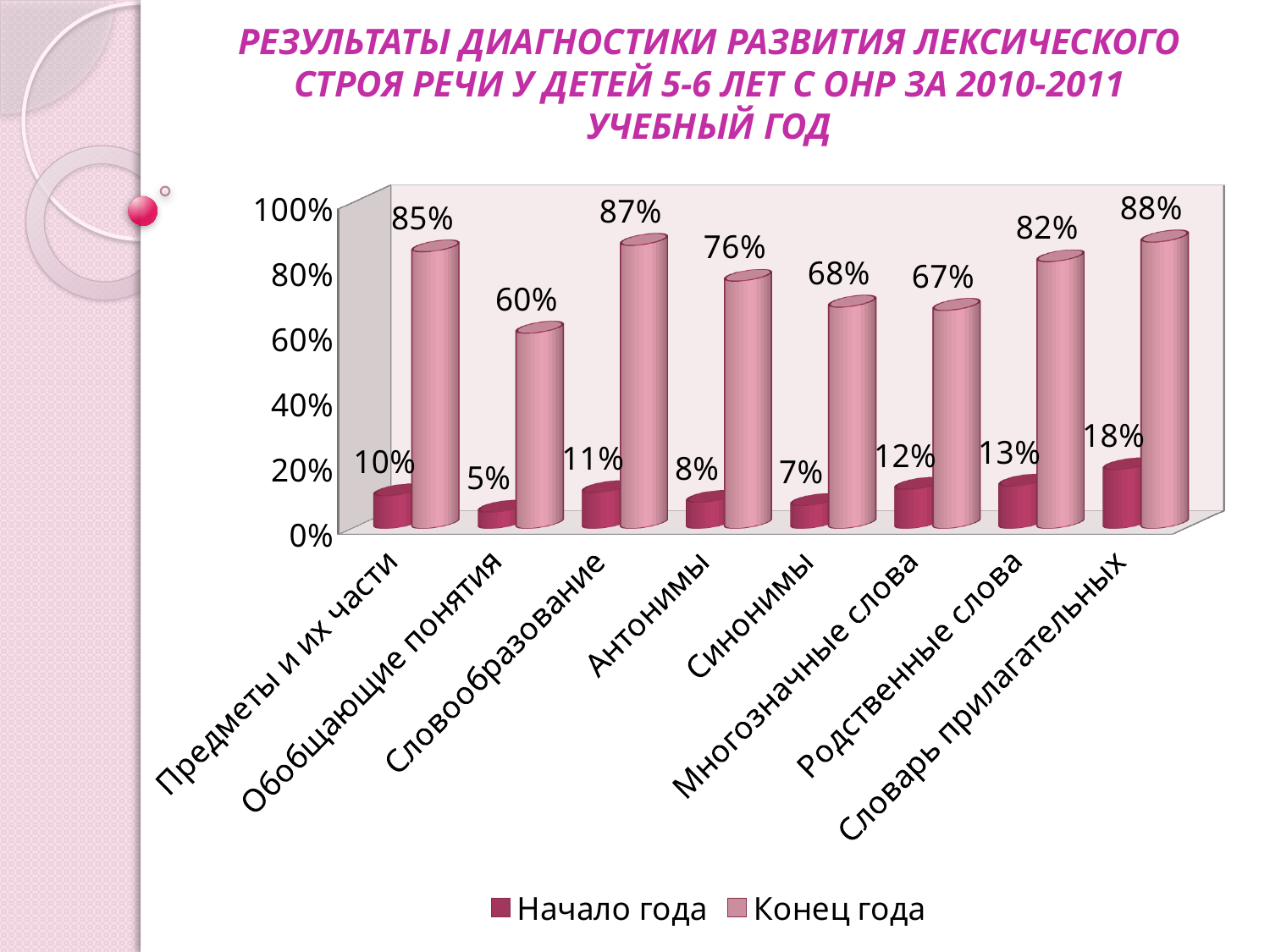
What is the value for Обобщающие понятия in the Начало года series? 5% How many categories are shown on the x axis? 8 Which category has the lowest value in the Начало года series? Обобщающие понятия What is the value for Синонимы in the Конец года series? 68% How many series does the legend list? 2 What is the difference between the Конец года and Начало года values for Антонимы? 68% Which is larger: the Конец года value for Родственные слова or for Многозначные слова? Родственные слова What kind of chart is shown on the slide? Bar chart Which category has the lowest value in the Конец года series? Обобщающие понятия What is the value for Словообразование in the Конец года series? 87% Which category has the highest value in the Конец года series? Словарь прилагательных What are the two series named in the legend? Начало года and Конец года